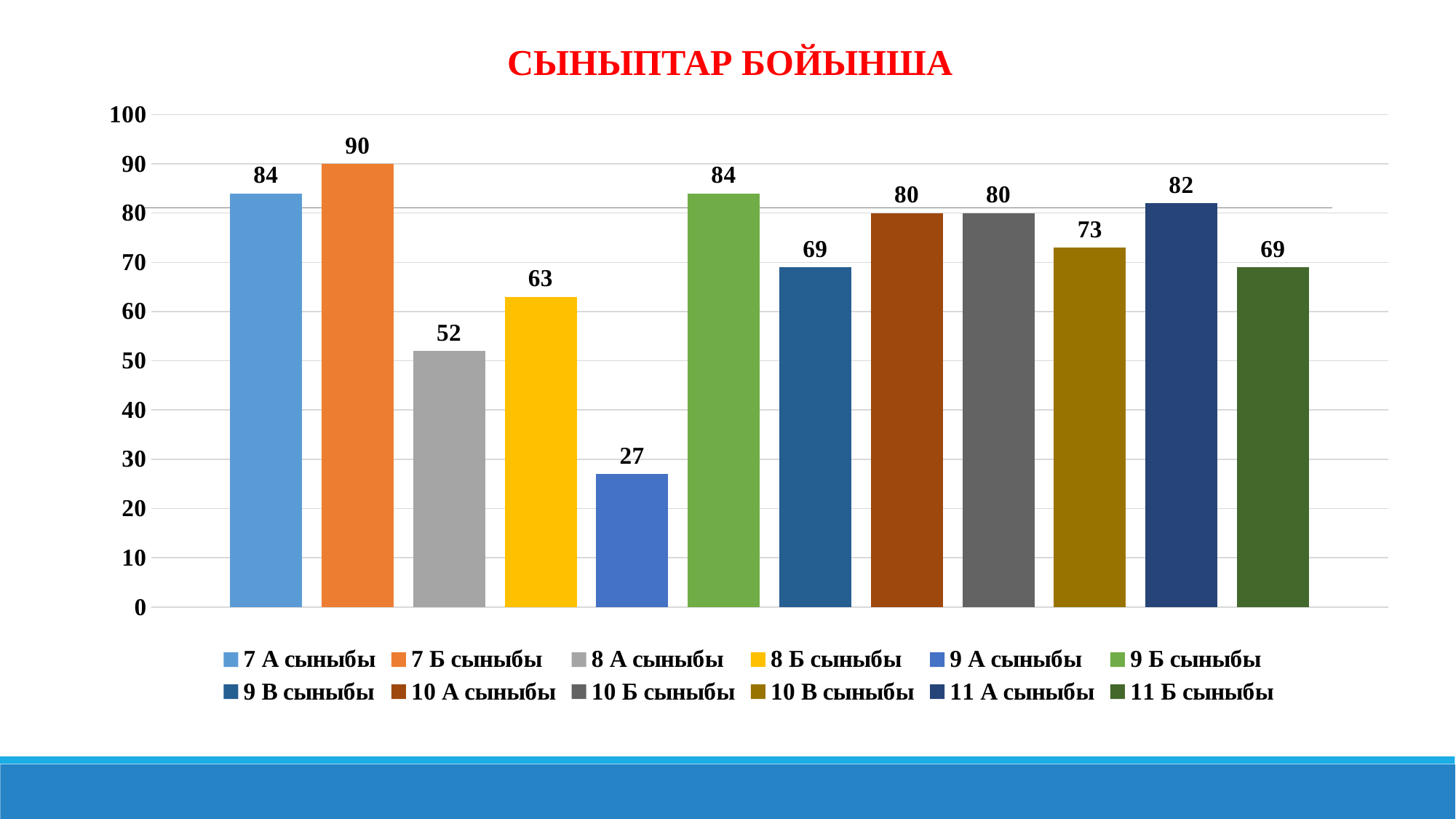
What is the value for 7 Б сыныбы? 90 What kind of chart is shown on the slide? bar chart What is the value for 9 А сыныбы? 27 What is the value for 11 А сыныбы? 82 Which is larger, the value for 8 Б сыныбы or the value for 9 В сыныбы? 9 В сыныбы How many bars are shown in the chart? 12 Which class has the highest value? 7 Б сыныбы What is the title of the chart? СЫНЫПТАР БОЙЫНША What is the value for 10 В сыныбы? 73 What is the difference between the values for 7 Б сыныбы and 8 А сыныбы? 38 Is the value for 8 А сыныбы greater or less than 60? less Which class has the lowest value? 9 А сыныбы